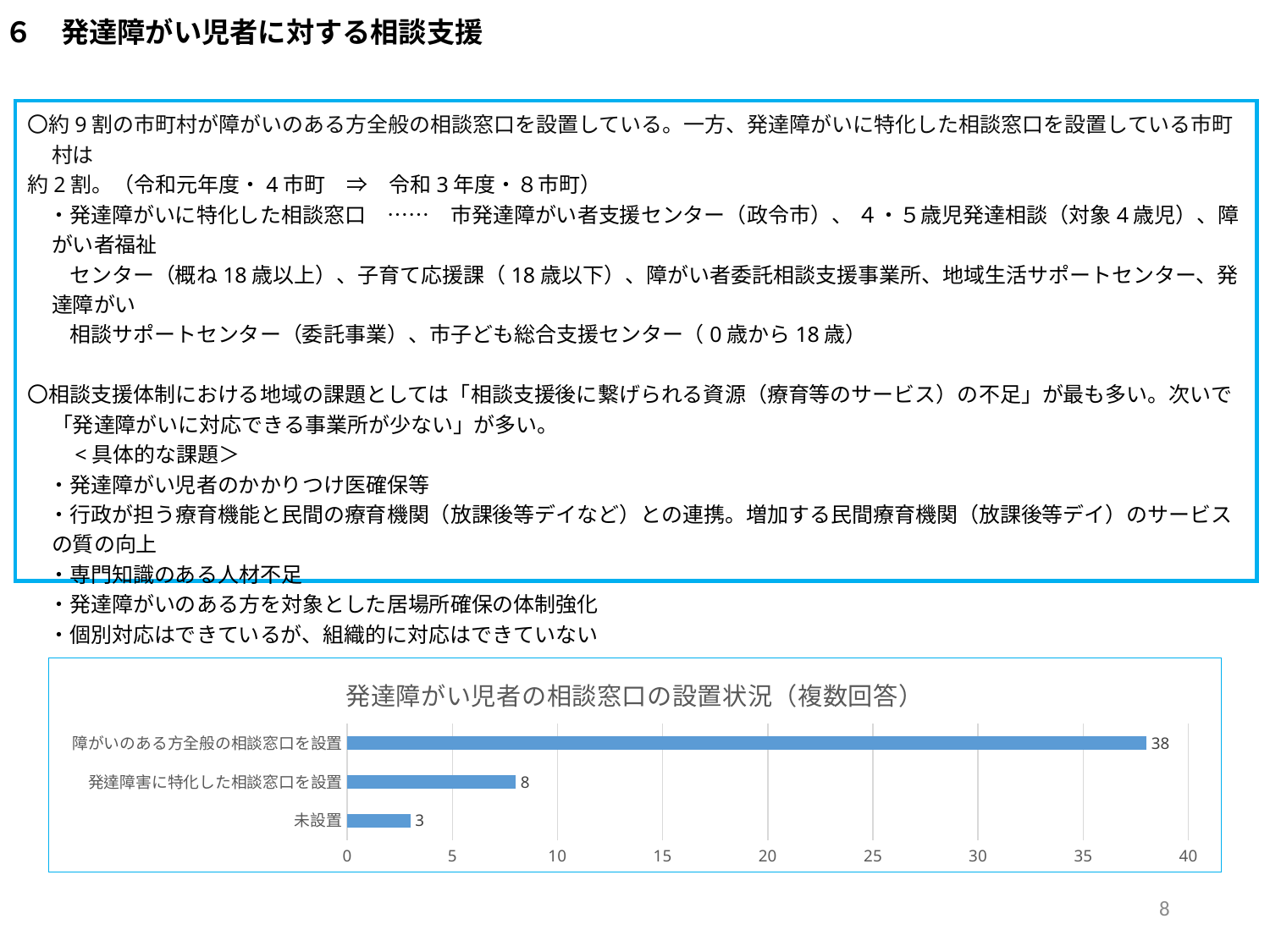
Which category has the lowest value? 未設置 Is the value for 障がいのある方全般の相談窓口を設置 greater or less than 35? greater What is the difference between the values for 障がいのある方全般の相談窓口を設置 and 発達障害に特化した相談窓口を設置? 30 What is the value for 障がいのある方全般の相談窓口を設置? 38 What kind of chart is shown on the slide? bar chart What is the value for 未設置? 3 Which is larger, the value for 発達障害に特化した相談窓口を設置 or the value for 未設置? 発達障害に特化した相談窓口を設置 Which category has the highest value? 障がいのある方全般の相談窓口を設置 What is the difference between the values for 発達障害に特化した相談窓口を設置 and 未設置? 5 What is the title of the chart? 発達障がい児者の相談窓口の設置状況（複数回答） What is the value for 発達障害に特化した相談窓口を設置? 8 How many categories are shown in the chart? 3